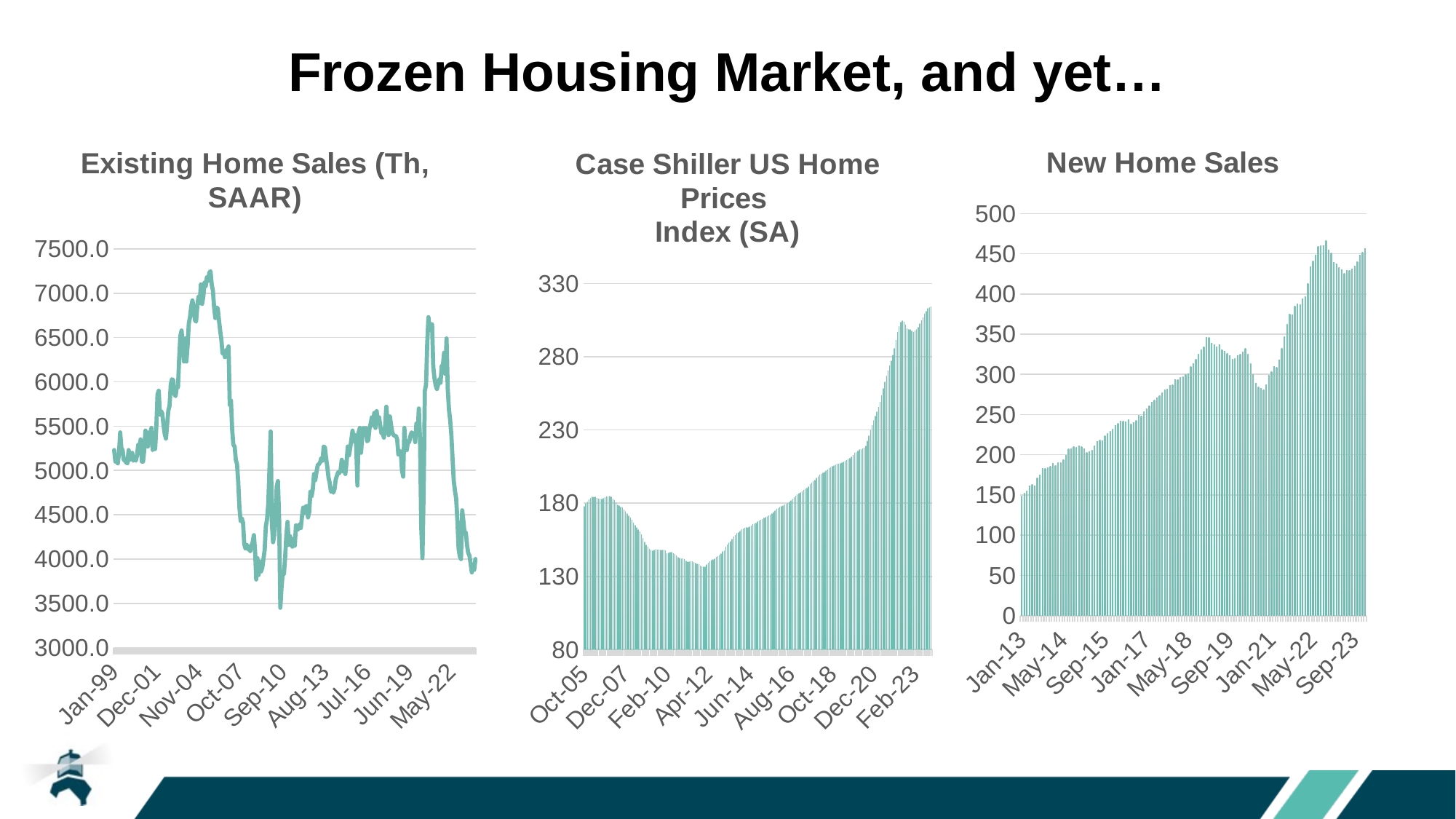
In the 'Existing Home Sales (Th, SAAR)' chart, is the value at Jan-99 greater or less than 5000.0? greater In the 'Case Shiller US Home Prices Index (SA)' chart, is the value at Apr-12 greater or less than 180? less How many charts are shown on the slide? 3 What kind of chart is the 'Existing Home Sales (Th, SAAR)' chart? line chart In the 'Case Shiller US Home Prices Index (SA)' chart, is the value at Feb-23 greater or less than 280? greater What is the title of the middle chart on the slide? Case Shiller US Home Prices Index (SA) In the 'Case Shiller US Home Prices Index (SA)' chart, do values rise or fall from Oct-18 to Feb-23? rise In the 'Existing Home Sales (Th, SAAR)' chart, do values rise or fall from Nov-04 to Oct-07? fall What kind of chart is the 'Case Shiller US Home Prices Index (SA)' chart? bar chart What kind of chart is the 'New Home Sales' chart? bar chart